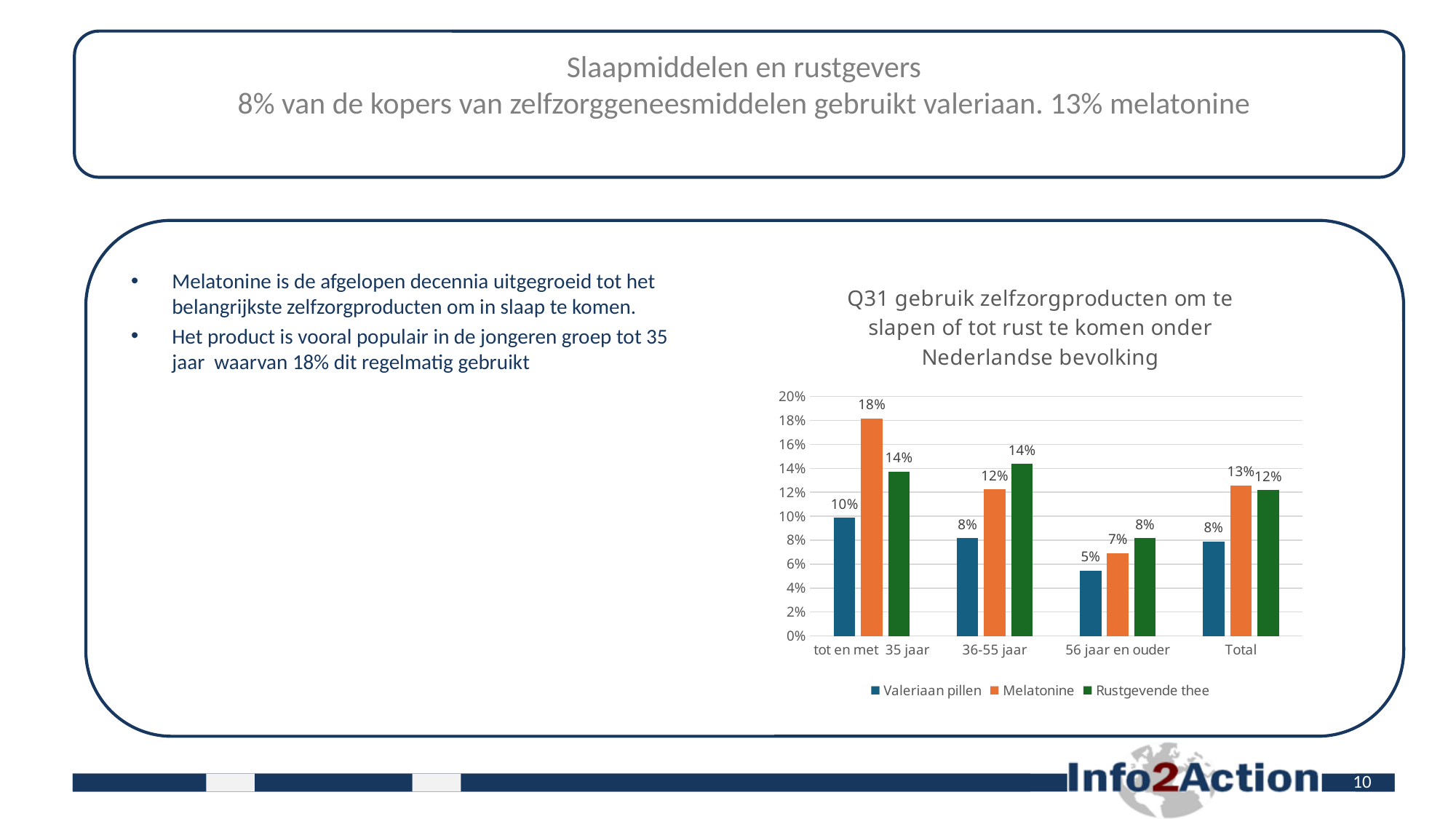
Which age group has the lowest value for Valeriaan pillen? 56 jaar en ouder What is the value for Valeriaan pillen in the '56 jaar en ouder' group? 5% Which age group has the highest value for Melatonine? tot en met 35 jaar What is the difference between the Melatonine value and the Valeriaan pillen value in the 'tot en met 35 jaar' group? 8% What type of chart is shown on the slide? bar chart How many series does the legend list? 3 How many age categories are shown on the x axis? 4 What is the value for Rustgevende thee in the '36-55 jaar' group? 14% What is the value for Melatonine in the Total group? 13% What is the title of the chart? Q31 gebruik zelfzorgproducten om te slapen of tot rust te komen onder Nederlandse bevolking In the '36-55 jaar' group, which is larger: Melatonine or Rustgevende thee? Rustgevende thee What is the value for Melatonine in the 'tot en met 35 jaar' group? 18%